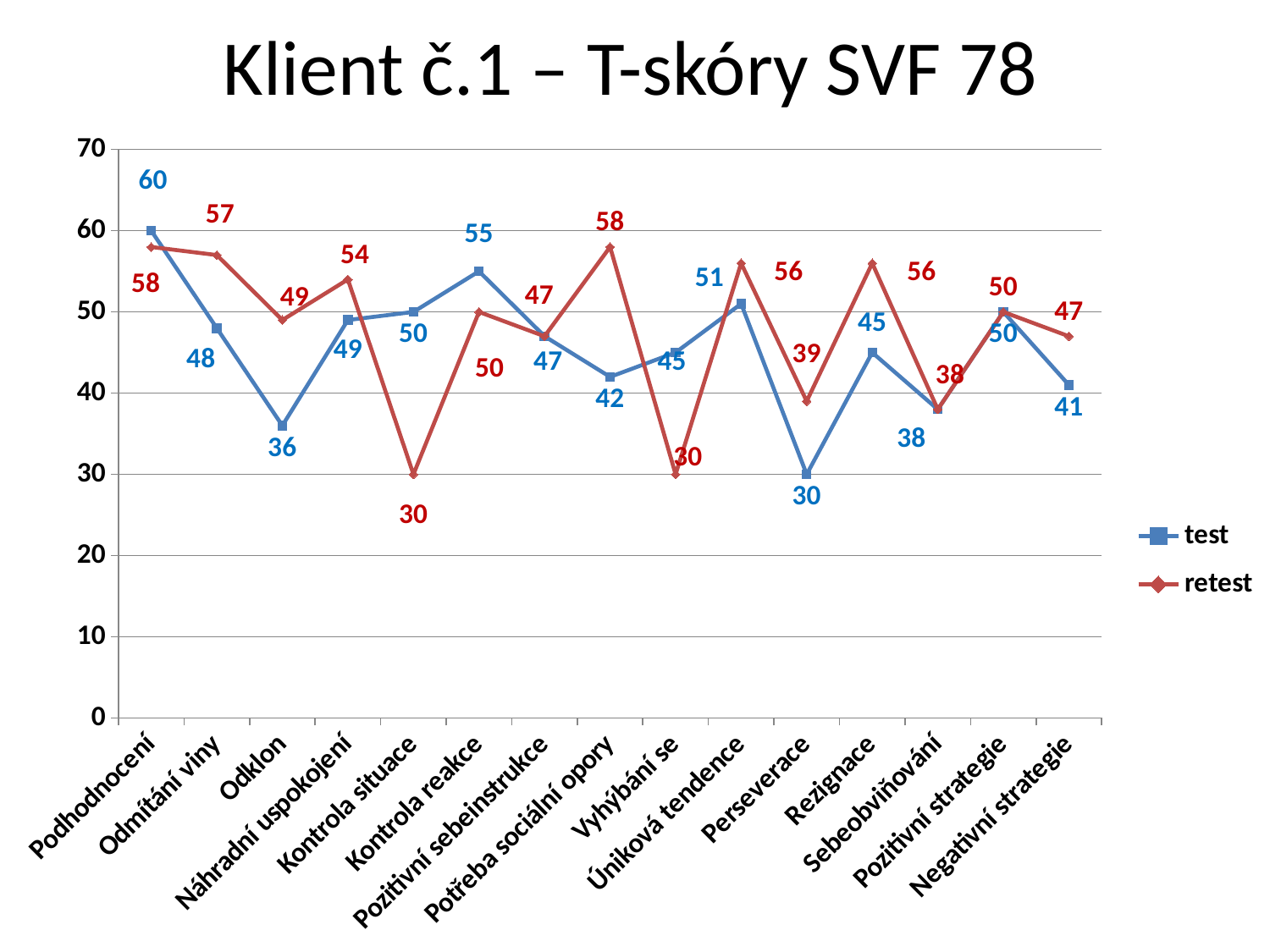
How many categories are shown on the x axis? 15 Which is larger for Vyhýbání se, the test value or the retest value? test Which category has the highest test value? Podhodnocení What is the difference between the retest and test values for Potřeba sociální opory? 16 What kind of chart is this? line chart What is the retest value for Rezignace? 56 What is the test value for Perseverace? 30 How many series does the legend list? 2 What is the retest value for Kontrola situace? 30 What is the test value for Odklon? 36 What is the title of the chart? Klient č.1 – T-skóry SVF 78 Which category has the lowest test value? Perseverace